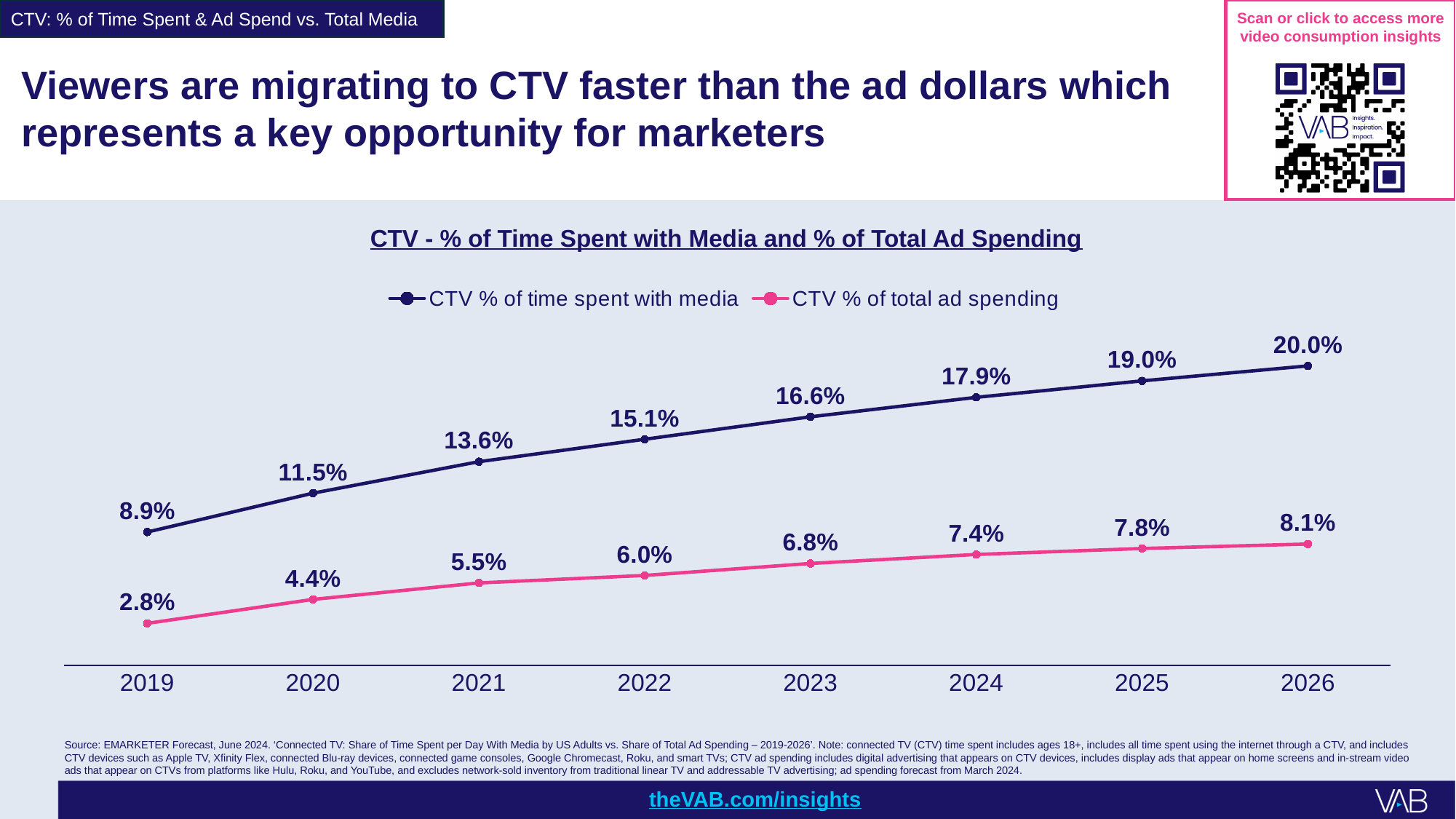
How many years are shown on the x axis? 8 By how much did the CTV % of total ad spending increase from 2019 to 2026? 5.3% How many series does the legend list? 2 What is the difference between CTV % of time spent with media and CTV % of total ad spending in 2026? 11.9% Does the CTV % of time spent with media rise or fall from 2019 to 2026? Rise In which year is the CTV % of total ad spending highest? 2026 Which is larger in 2021: CTV % of time spent with media or CTV % of total ad spending? CTV % of time spent with media What kind of chart is shown on the slide? Line chart In which year is the CTV % of time spent with media lowest? 2019 What is the CTV % of total ad spending in 2024? 7.4% What is the CTV % of time spent with media in 2022? 15.1% What is the CTV % of time spent with media in 2019? 8.9%